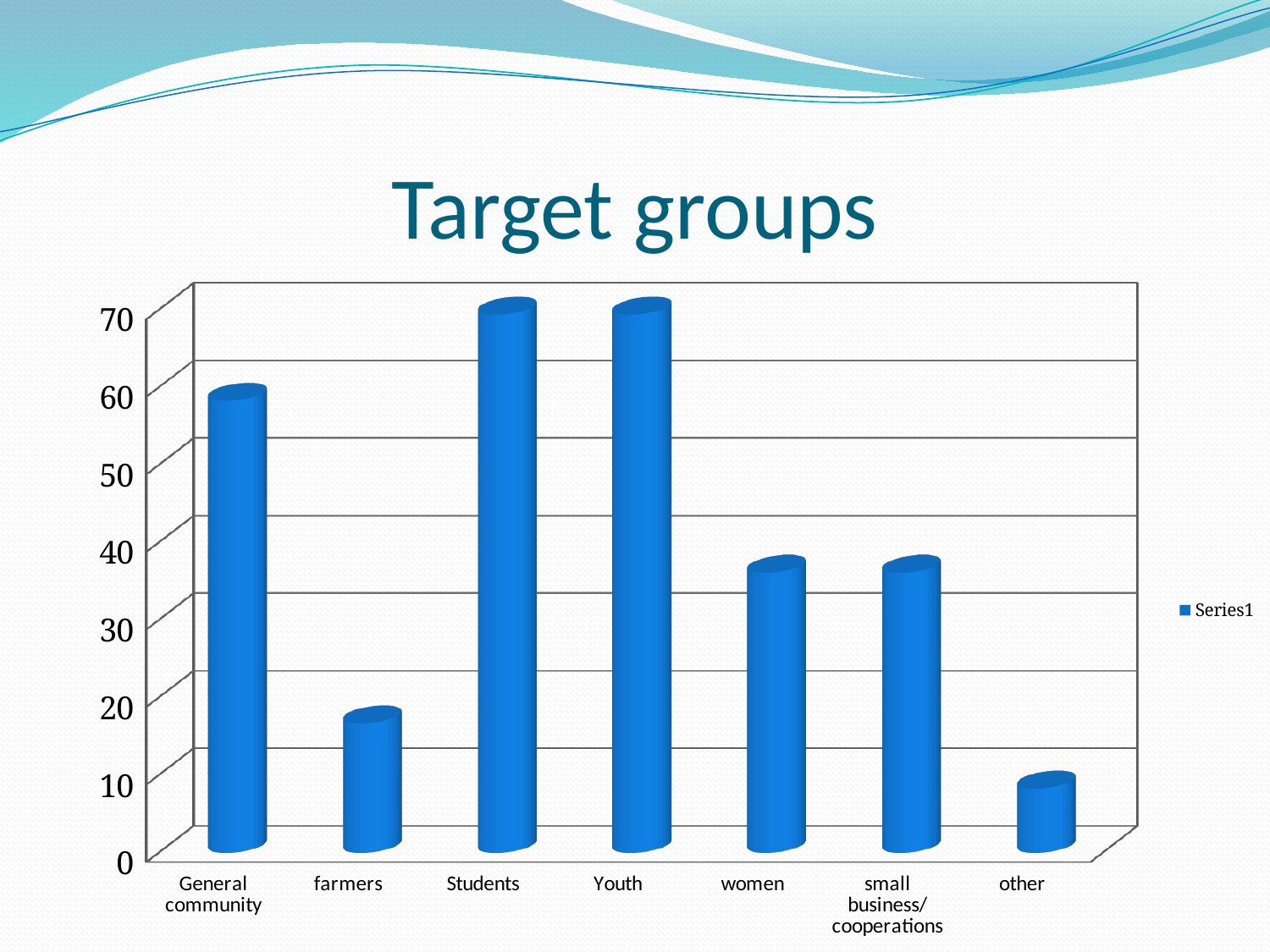
What is the title of the chart? Target groups Which is larger, the value for women or the value for other? women How many categories are shown on the x axis of the chart? 7 Is the value for Students greater or less than 60? greater How many series does the legend list? 1 Is the value for farmers greater or less than 30? less What kind of chart is shown on the slide? bar chart Which category has the lowest value? other Which is larger, the value for General community or the value for farmers? General community Is the value for General community greater or less than 50? greater